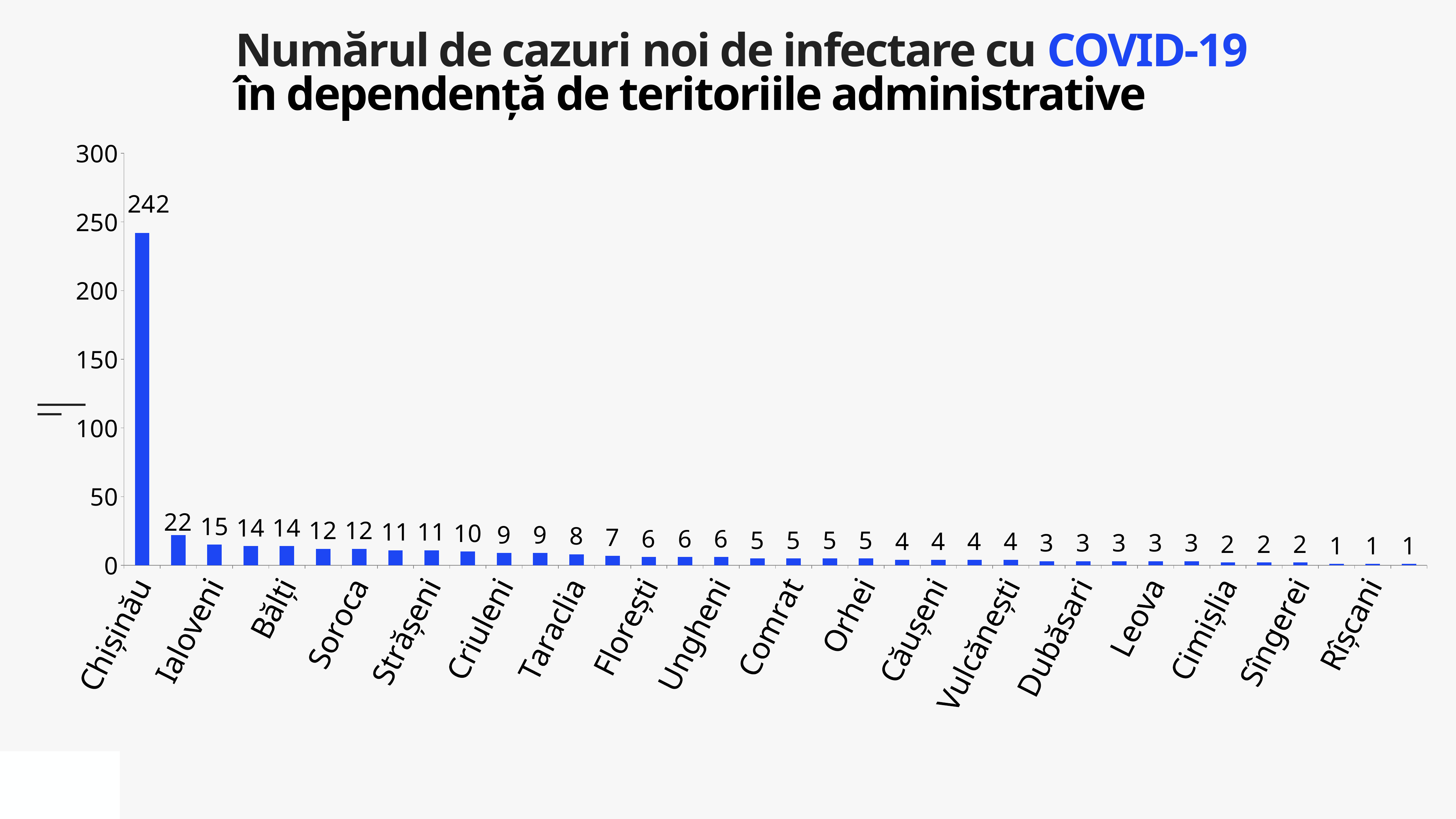
Do the values rise or fall from left to right along the x axis? fall What is the highest tick value shown on the vertical axis? 300 What colour are the bars in the chart? blue What is the value for Chișinău? 242 What is the difference between the values for Chișinău and Ialoveni? 227 Which is larger, the value for Chișinău or the value for Ialoveni? Chișinău Is the value for Chișinău greater or less than 200? greater Which category has the highest value? Chișinău Is the value for Ialoveni greater or less than 50? less What type of chart is shown on the slide? bar chart What is the value for Ialoveni? 15